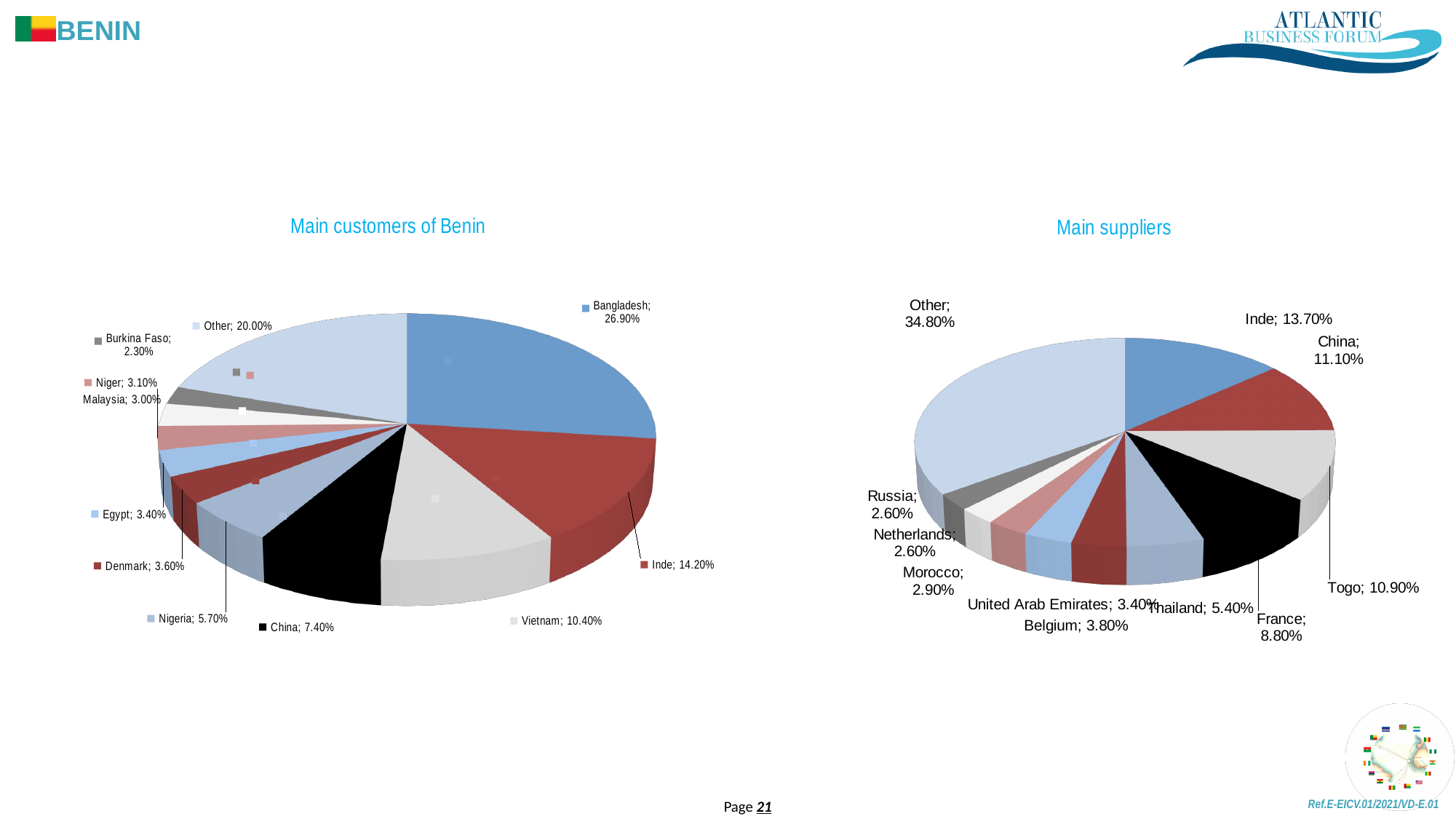
In the 'Main customers of Benin' chart, which is larger, Nigeria or Denmark? Nigeria In the 'Main suppliers' chart, which named country (excluding 'Other') has the largest share? Inde In the 'Main customers of Benin' chart, which named country (excluding 'Other') has the smallest share? Burkina Faso In the 'Main customers of Benin' chart, what is the difference between the shares of Inde and China? 6.80% In the 'Main suppliers' chart, what is the difference between the shares of France and Thailand? 3.40% How many slices does the 'Main customers of Benin' pie chart have? 11 In the 'Main customers of Benin' chart, what share does Bangladesh have? 26.90% In the 'Main suppliers' chart, which slice is the largest? Other What is the title of the pie chart on the right side of the slide? Main suppliers What kind of chart is the 'Main customers of Benin' chart? pie chart In the 'Main customers of Benin' chart, what is the value for Vietnam? 10.40% In the 'Main suppliers' chart, what is the share for Togo? 10.90%